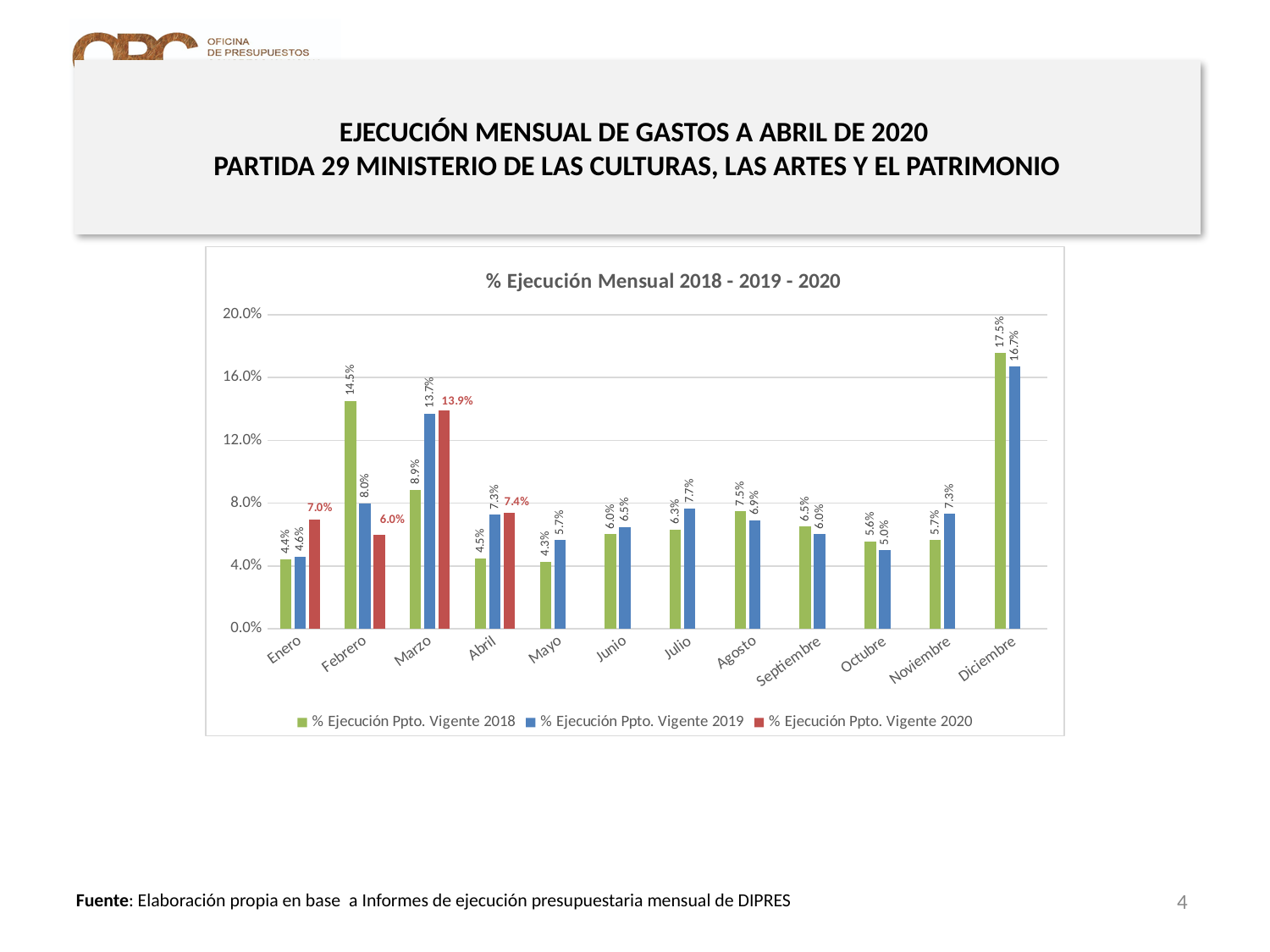
Which is larger for Febrero: the 2018 value or the 2019 value? 2018 value What is the title of the chart? % Ejecución Mensual 2018 - 2019 - 2020 What is the % Ejecución Ppto. Vigente 2019 value for Noviembre? 7.3% What is the difference between the 2019 and 2018 values for Diciembre? 0.8% What is the % Ejecución Ppto. Vigente 2020 value for Marzo? 13.9% What is the % Ejecución Ppto. Vigente 2018 value for Febrero? 14.5% What kind of chart is shown on the slide? Bar chart Which month has the highest % Ejecución Ppto. Vigente 2018 value? Diciembre How many series does the legend list? 3 Is the % Ejecución Ppto. Vigente 2019 value for Marzo greater or less than 12.0%? greater Which month has the lowest % Ejecución Ppto. Vigente 2019 value? Enero How many months are shown on the x axis? 12